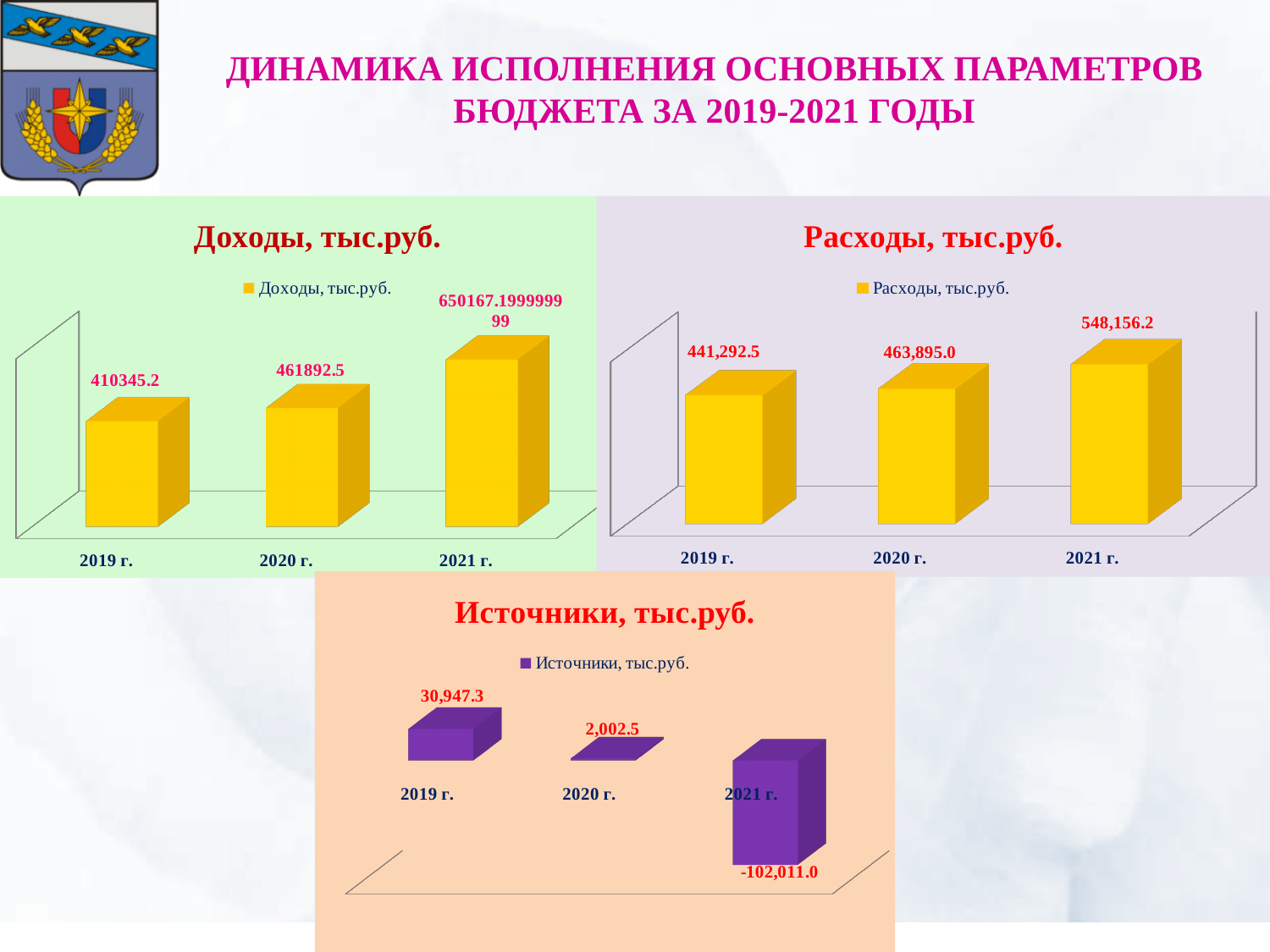
In the 'Доходы, тыс.руб.' chart, do the values rise or fall from 2019 г. to 2021 г.? rise In the 'Источники, тыс.руб.' chart, which is larger: the value for 2019 г. or 2020 г.? 2019 г. In the 'Расходы, тыс.руб.' chart, what is the difference between the values for 2021 г. and 2019 г.? 106,863.7 In the 'Расходы, тыс.руб.' chart, which year has the lowest value? 2019 г. How many charts are shown on the slide? 3 In the 'Расходы, тыс.руб.' chart, what is the value for 2020 г.? 463,895.0 In the 'Доходы, тыс.руб.' chart, what is the difference between the values for 2020 г. and 2019 г.? 51547.3 In the 'Источники, тыс.руб.' chart, what is the value for 2021 г.? -102,011.0 In the 'Доходы, тыс.руб.' chart, what is the value for 2019 г.? 410345.2 In the 'Доходы, тыс.руб.' chart, what is the value for 2020 г.? 461892.5 In the 'Расходы, тыс.руб.' chart, what is the value for 2021 г.? 548,156.2 In the 'Источники, тыс.руб.' chart, which year has the highest value? 2019 г.